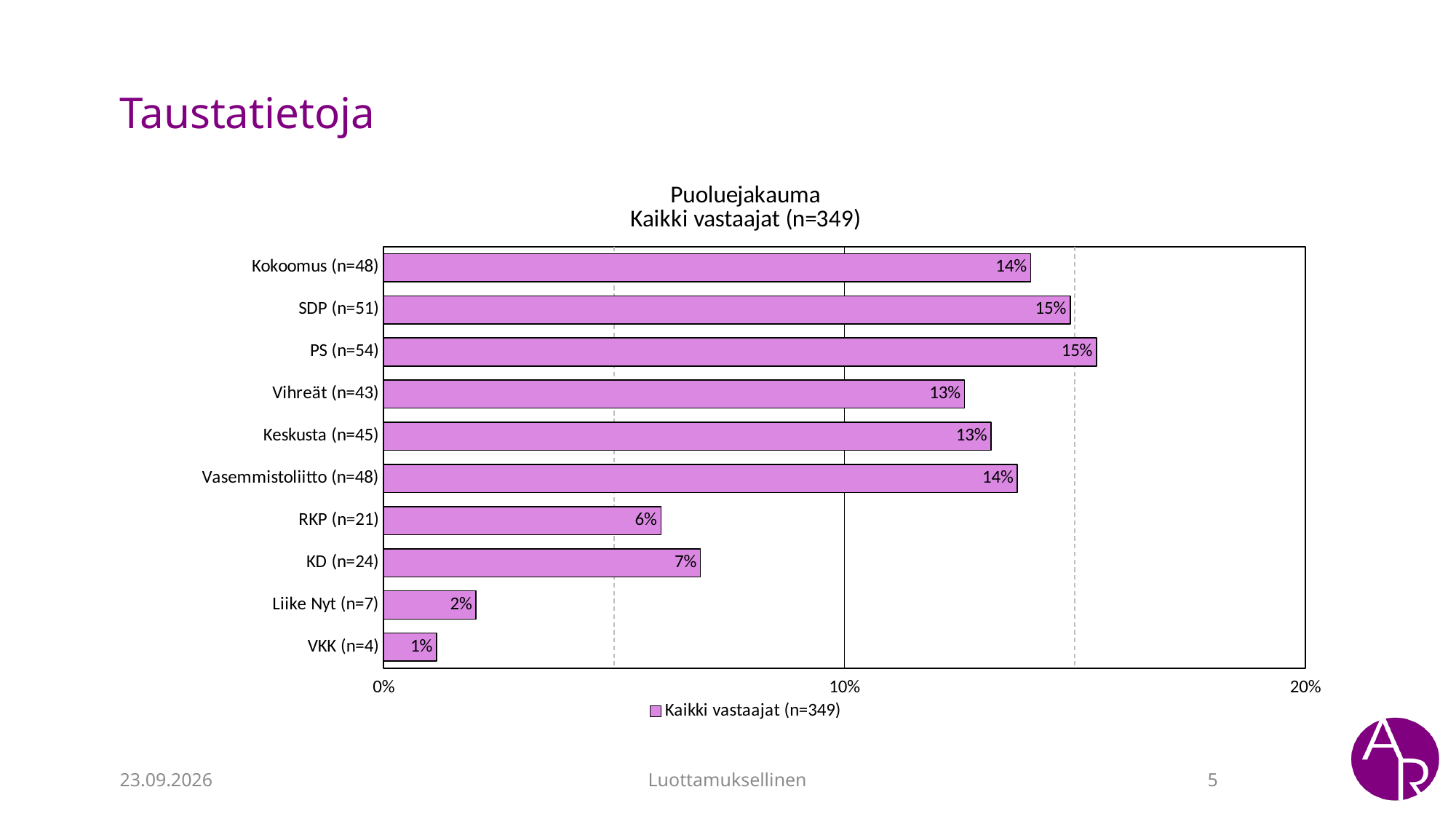
What is the difference between the values for Kokoomus (n=48) and KD (n=24)? 7% What kind of chart is shown on the slide? bar chart Which is larger, the value for KD (n=24) or the value for RKP (n=21)? KD (n=24) Which category has the lowest value? VKK (n=4) What is the legend entry shown below the chart? Kaikki vastaajat (n=349) What is the value for Kokoomus (n=48)? 14% Is the value for Vihreät (n=43) greater or less than 10%? greater What is the difference between the values for PS (n=54) and RKP (n=21)? 9% What is the value for RKP (n=21)? 6% Is the value for KD (n=24) greater or less than 10%? less How many categories are shown in the chart? 10 What is the value for Liike Nyt (n=7)? 2%